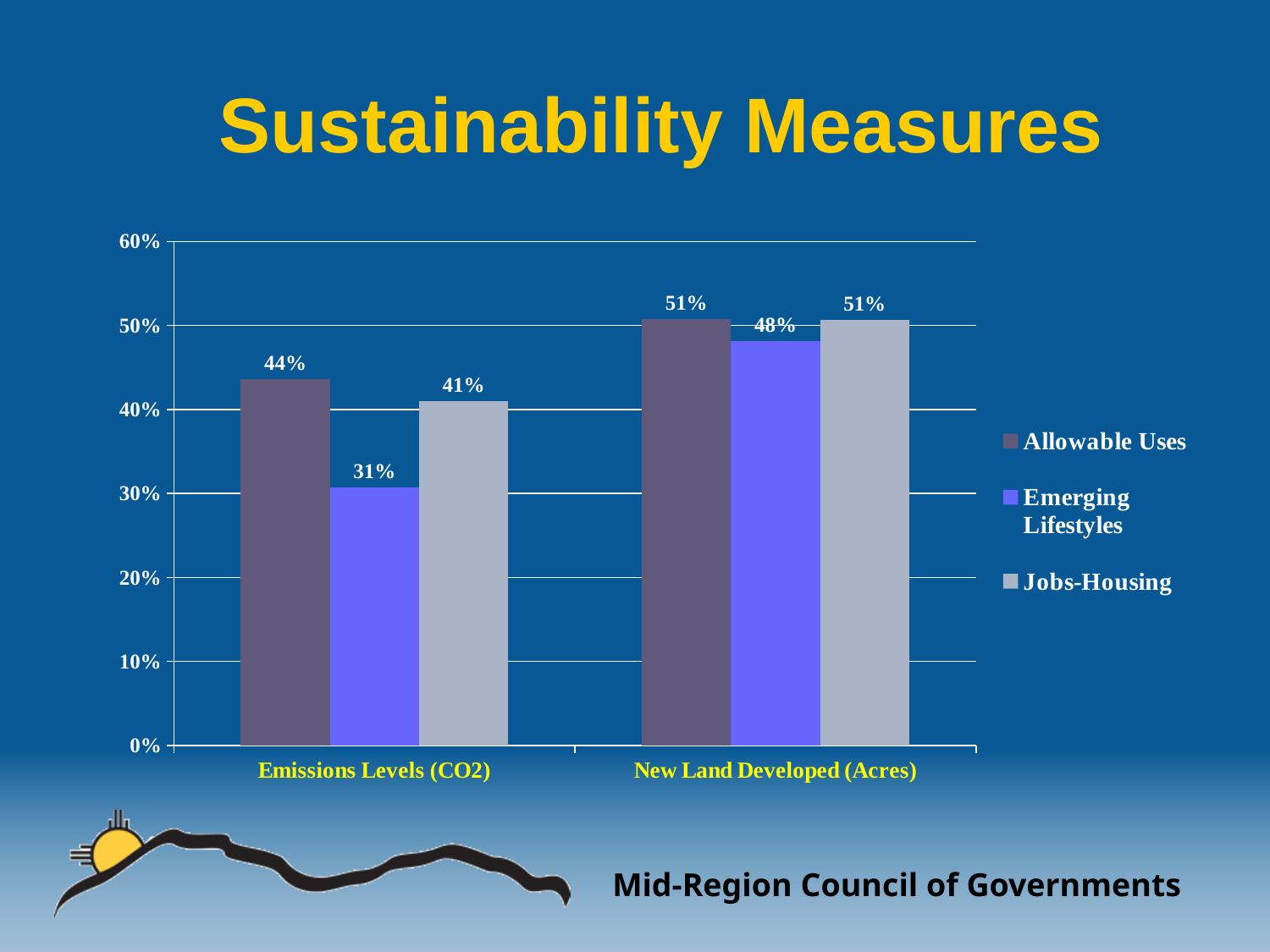
Which series has the lowest value in the New Land Developed (Acres) category? Emerging Lifestyles How many series does the legend list? 3 What is the value for Jobs-Housing in the Emissions Levels (CO2) category? 41% What kind of chart is shown on the slide? Bar chart Which is larger: Allowable Uses for Emissions Levels (CO2) or Allowable Uses for New Land Developed (Acres)? New Land Developed (Acres) Is the value for Emerging Lifestyles in the New Land Developed (Acres) category greater or less than 40%? greater Which series has the lowest value in the Emissions Levels (CO2) category? Emerging Lifestyles What is the difference between the Jobs-Housing and Emerging Lifestyles values in the New Land Developed (Acres) category? 3% What is the value for Allowable Uses in the New Land Developed (Acres) category? 51% What is the difference between the Allowable Uses and Emerging Lifestyles values in the Emissions Levels (CO2) category? 13% How many categories are shown on the x axis? 2 What is the value for Emerging Lifestyles in the Emissions Levels (CO2) category? 31%